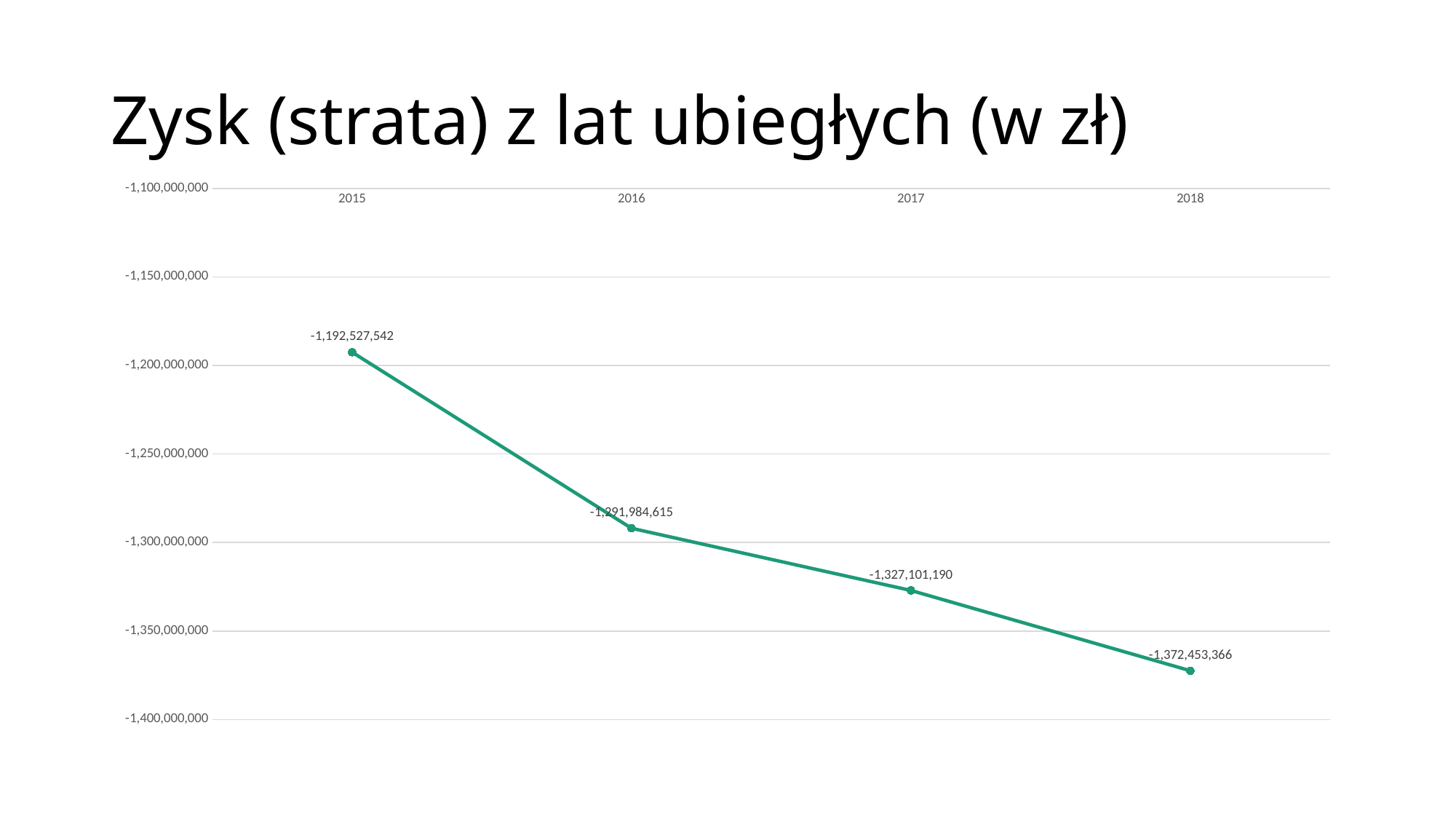
What kind of chart is shown? line chart Which is larger, the value for 2016 or the value for 2017? 2016 What is the value for 2018? -1,372,453,366 Is the value for 2017 greater or less than -1,300,000,000? less Which year has the lowest value? 2018 What is the difference between the values for 2015 and 2016? 99,457,073 What is the value for 2017? -1,327,101,190 What is the difference between the values for 2017 and 2018? 45,352,176 How many years are plotted on the chart? 4 What is the value for 2015? -1,192,527,542 What is the value for 2016? -1,291,984,615 Which year has the highest value? 2015